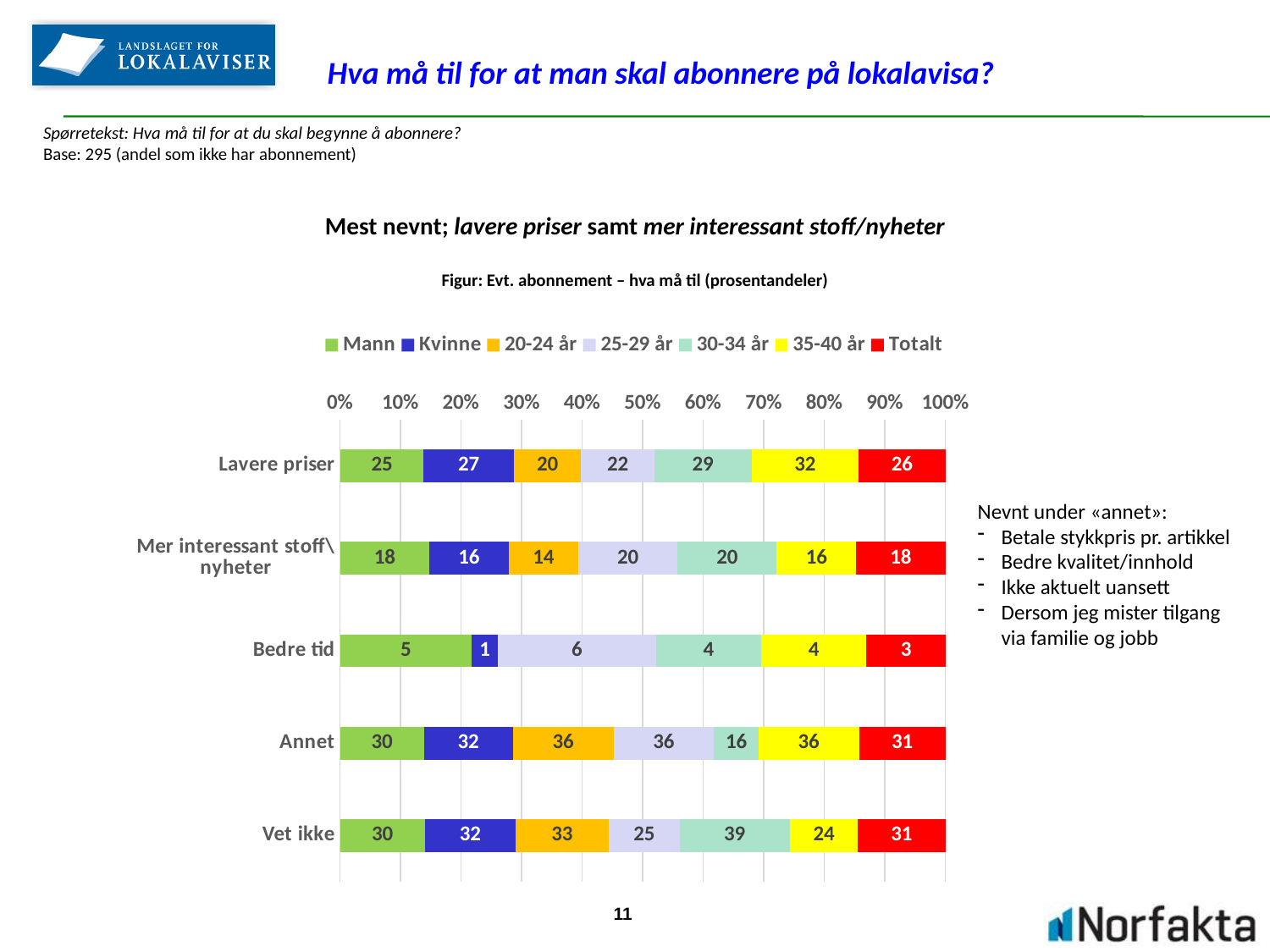
Which category has the highest value for 35-40 år? Annet Which category has the lowest value for Totalt? Bedre tid What is the value for 30-34 år in the Vet ikke category? 39 What is the difference between the Mann and Kvinne values for Lavere priser? 2 Which is larger for Vet ikke: the value for 20-24 år or the value for 25-29 år? 20-24 år How many categories are shown on the vertical axis? 5 What is the value for 20-24 år in the Annet category? 36 What kind of chart is shown on the slide? Stacked bar chart What is the value for Totalt in the Lavere priser category? 26 Which colour represents the Totalt series in the chart? Red How many series does the legend list? 7 What is the value for Kvinne in the Mer interessant stoff\nyheter category? 16